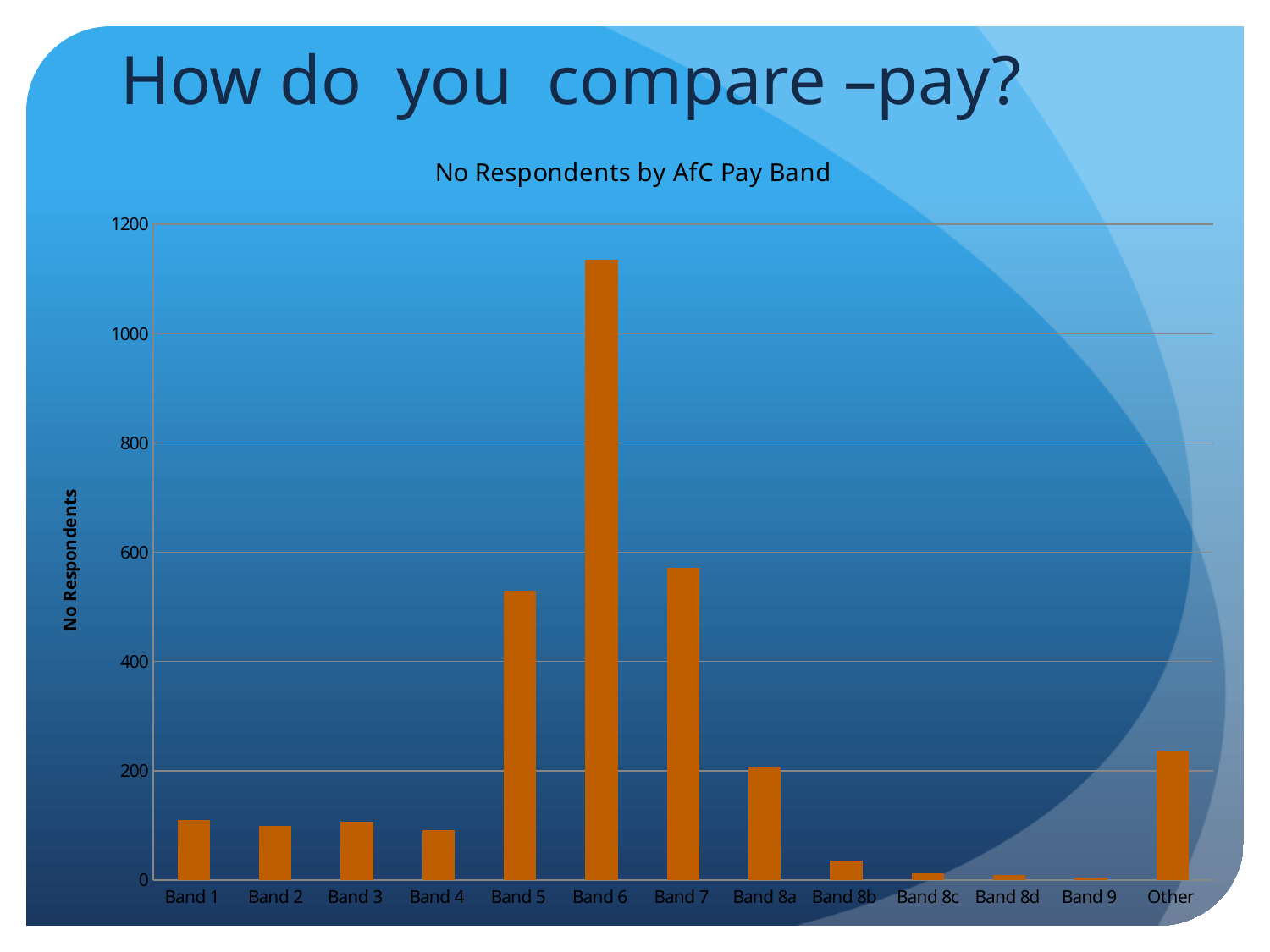
Is the value for Band 6 greater or less than 1000? greater Which has more respondents, Other or Band 8a? Other Is the value for Band 7 greater or less than 600? less Which has more respondents, Band 6 or Band 7? Band 6 What is the label on the vertical axis of the chart? No Respondents Which pay band has the highest number of respondents? Band 6 Is the value for Band 5 greater or less than 400? greater What type of chart is shown on the slide? Bar chart How many pay band categories are shown on the x axis? 13 What is the title of the chart? No Respondents by AfC Pay Band